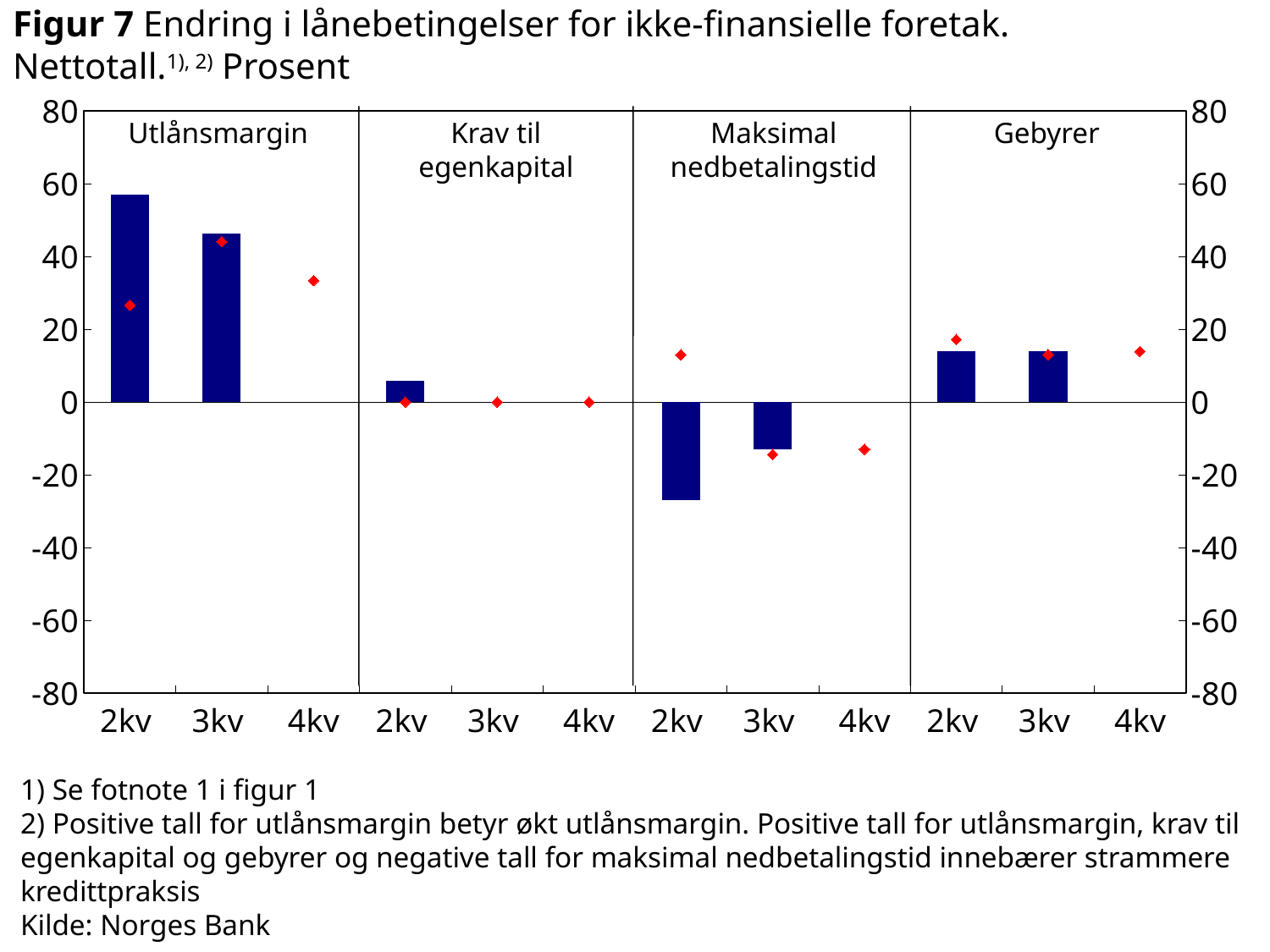
In the Utlånsmargin panel, which bar is taller, 2kv or 3kv? 2kv Which panel contains the lowest (most negative) bar? Maksimal nedbetalingstid Is the 2kv bar for Maksimal nedbetalingstid greater or less than -20? less Is the 2kv bar for Utlånsmargin greater or less than 40? greater In the Maksimal nedbetalingstid panel, which bar is more negative, 2kv or 3kv? 2kv Which panel has the tallest bar? Utlånsmargin What is the figure number given in the chart title? Figur 7 Is the 2kv bar for Krav til egenkapital greater or less than 20? less Do the bars in the Utlånsmargin panel rise or fall from 2kv to 3kv? fall How many panels (lending condition categories) does the chart have? 4 What kind of chart is shown on the slide? bar chart